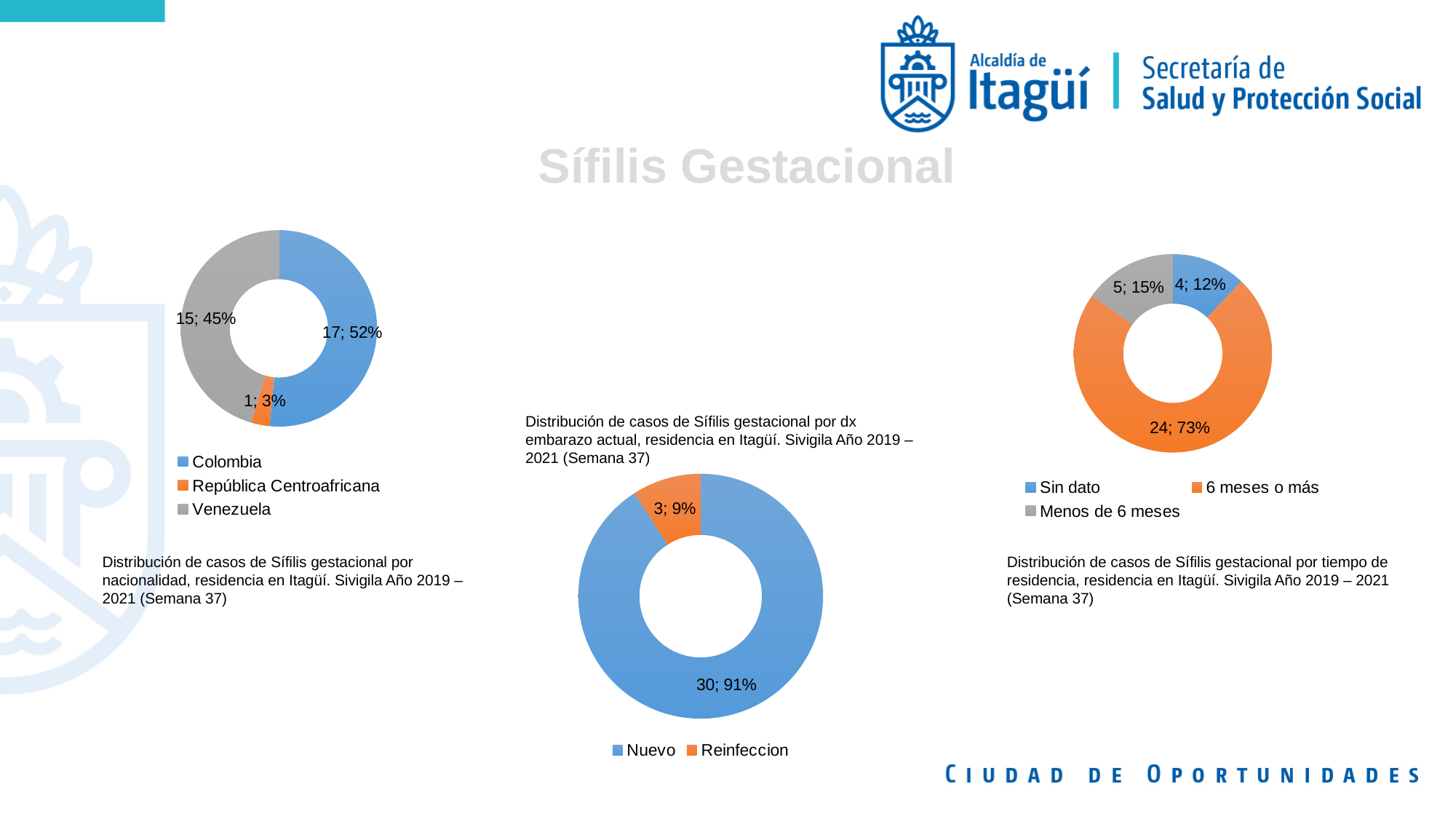
In the middle chart (by dx embarazo actual), what share of cases is Reinfeccion? 9% In the left chart (by nationality), which category has the fewest cases? República Centroafricana In the middle chart (by dx embarazo actual), what is the total number of cases across both categories? 33 In the middle chart (by dx embarazo actual), how many cases are Nuevo? 30 In the right chart (by tiempo de residencia), how many cases are '6 meses o más'? 24 In the left chart (by nationality), how many categories does the legend list? 3 In the left chart (by nationality), what share of cases is Venezuela? 45% In the right chart (by tiempo de residencia), which is larger: 'Sin dato' or 'Menos de 6 meses'? Menos de 6 meses In the left chart (by nationality), what is the difference in cases between Colombia and Venezuela? 2 In the left chart (by nationality), how many cases are from Colombia? 17 What kind of chart is used for the three charts on the slide? Donut (pie) chart In the right chart (by tiempo de residencia), which category has the largest share? 6 meses o más